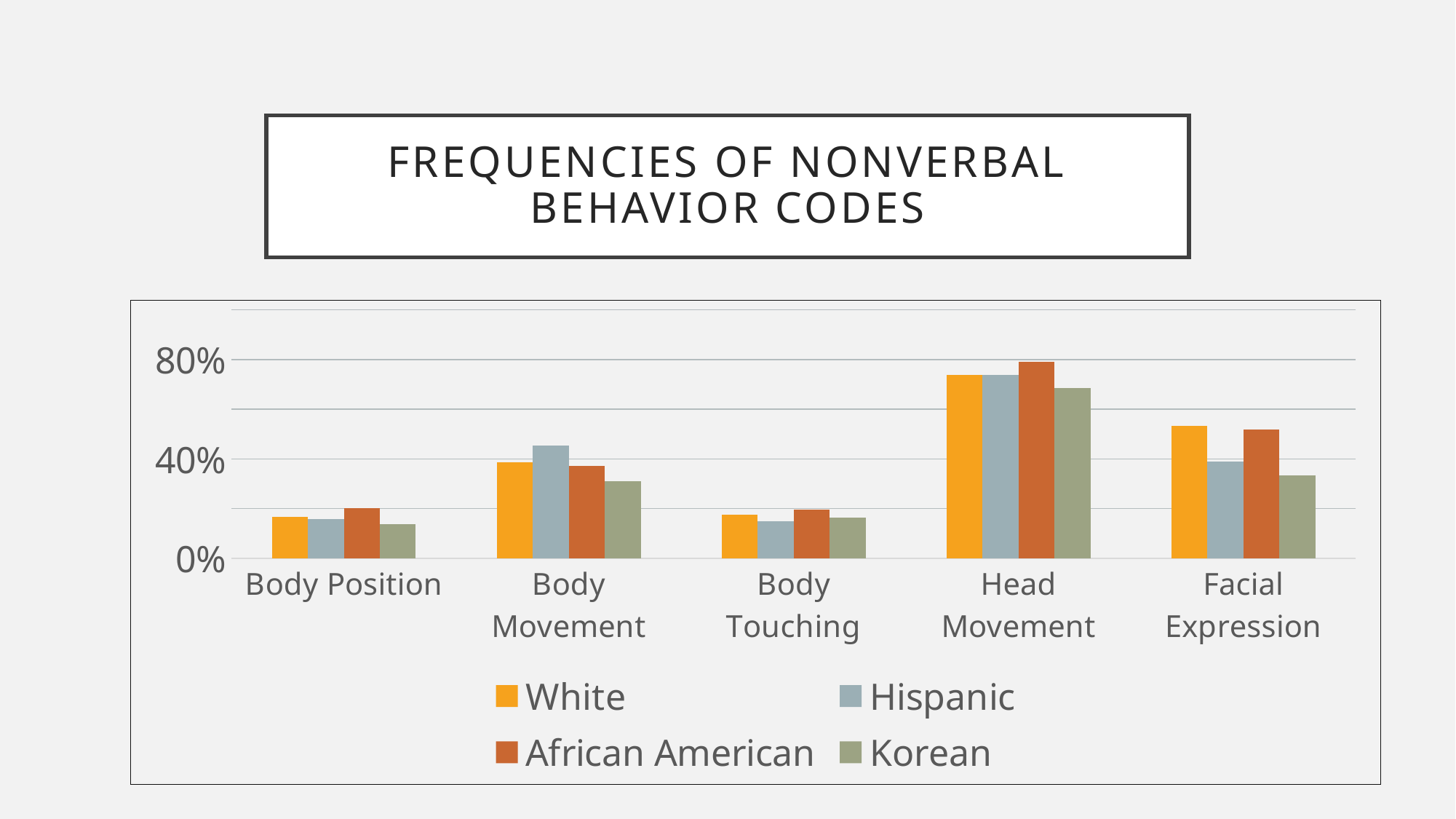
How many series does the legend list? 4 How many behavior code categories are shown on the x axis? 5 Which is larger: the Korean value for Head Movement or the White value for Facial Expression? Korean value for Head Movement What is the title of the slide? Frequencies of Nonverbal Behavior Codes Within the Facial Expression category, which series has the lowest bar? Korean Within the Body Movement category, which series has the highest bar? Hispanic Within the Head Movement category, which series has the lowest bar? Korean Which behavior code category has the tallest bars overall? Head Movement Within the Head Movement category, which series has the highest bar? African American Is the value for Hispanic in Body Movement greater or less than 40%? greater What kind of chart is shown on the slide? Bar chart